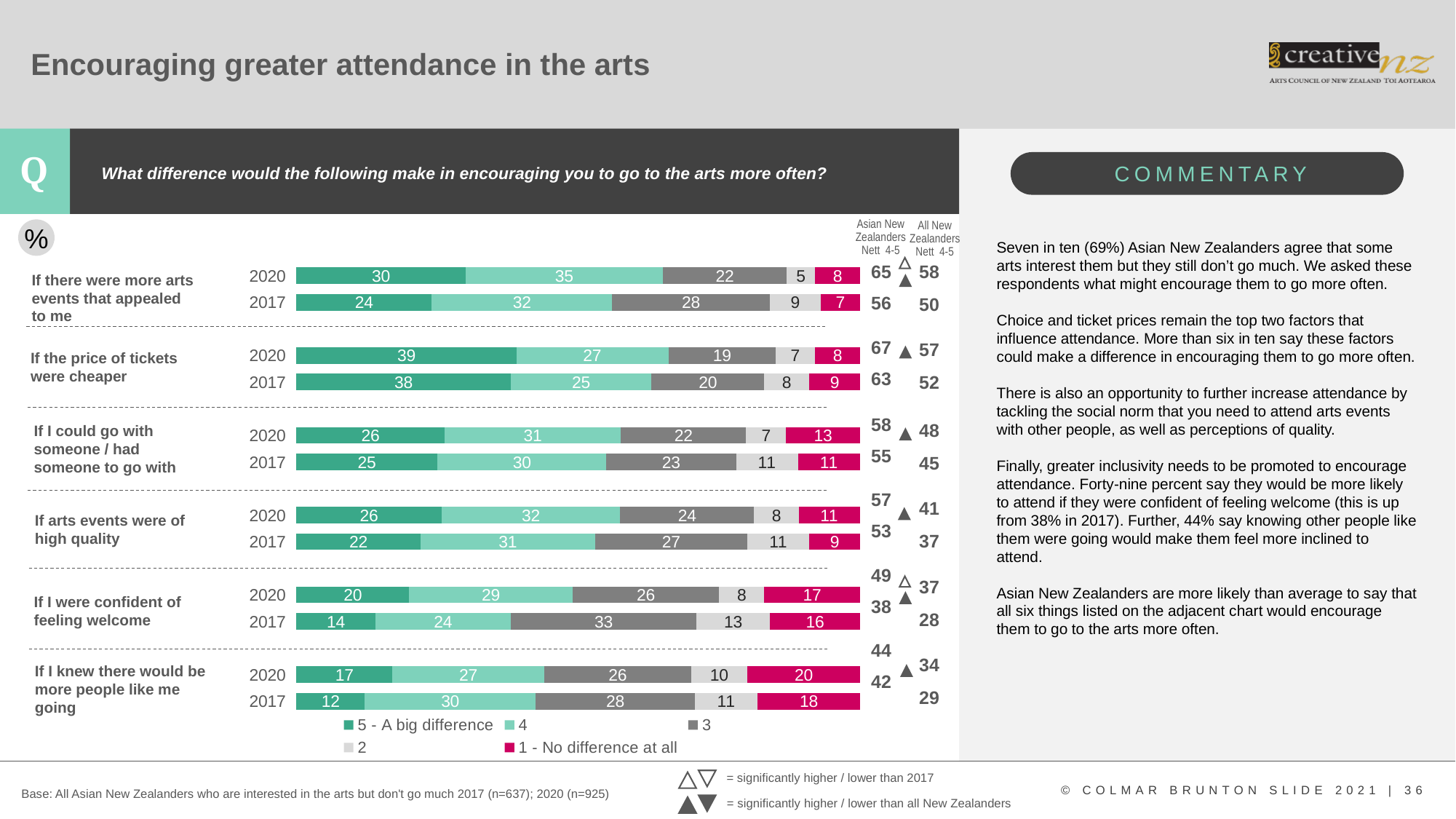
What is the total of the 2020 stacked bar for 'If there were more arts events that appealed to me'? 100 How many statements (categories) are shown in the chart? 6 Which statement has the highest '5 - A big difference' value in 2020? If the price of tickets were cheaper How many series does the chart legend list? 5 What label does the legend give to the dark pink series? 1 - No difference at all What percentage of Asian New Zealanders in 2020 said cheaper ticket prices would make '5 - A big difference'? 39 In 2017, what percentage said 'If I were confident of feeling welcome' would make '1 - No difference at all'? 16 Which statement has the lowest '5 - A big difference' value in 2017? If I knew there would be more people like me going By how many points did the '5 - A big difference' value for 'If I were confident of feeling welcome' change from 2017 to 2020? 6 What kind of chart is shown on the slide? Stacked bar chart Which is larger: the 2020 '1 - No difference at all' value for 'If I could go with someone / had someone to go with' or for 'If arts events were of high quality'? If I could go with someone / had someone to go with What is the 2020 value for '3' in the 'If I knew there would be more people like me going' bar? 26